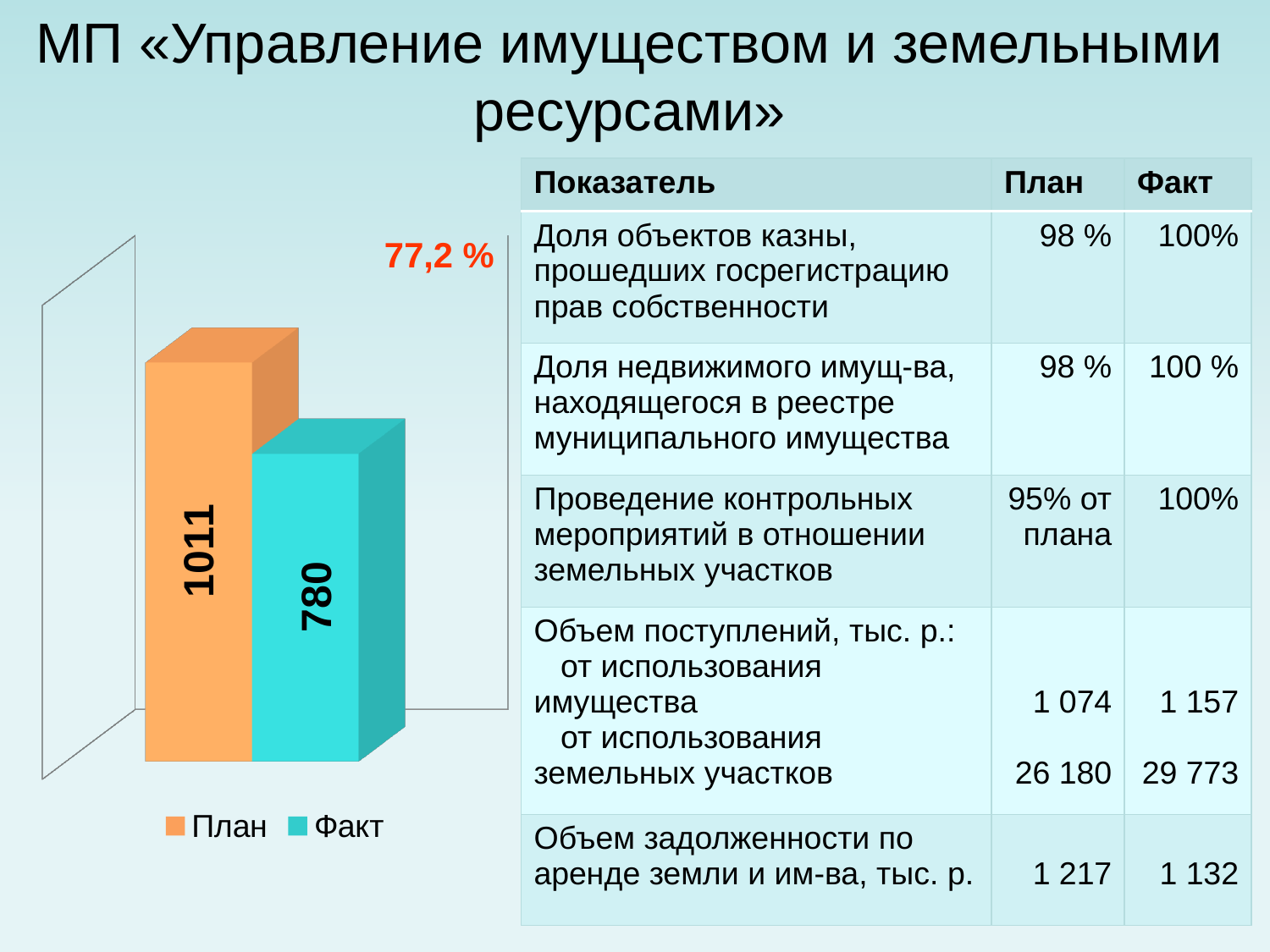
Is the Факт bar larger or smaller than the План bar? smaller Which series has the higher bar in the chart, План or Факт? План What is the value of the Факт bar in the chart? 780 How many bars are plotted in the chart? 2 What colour is the Факт bar in the chart? turquoise What is the value of the План bar in the chart? 1011 How many series does the chart legend list? 2 What is the difference between the План bar and the Факт bar? 231 What kind of chart is shown on the slide? bar chart What percentage is printed in red above the chart? 77,2 % Which series has the lower bar in the chart? Факт